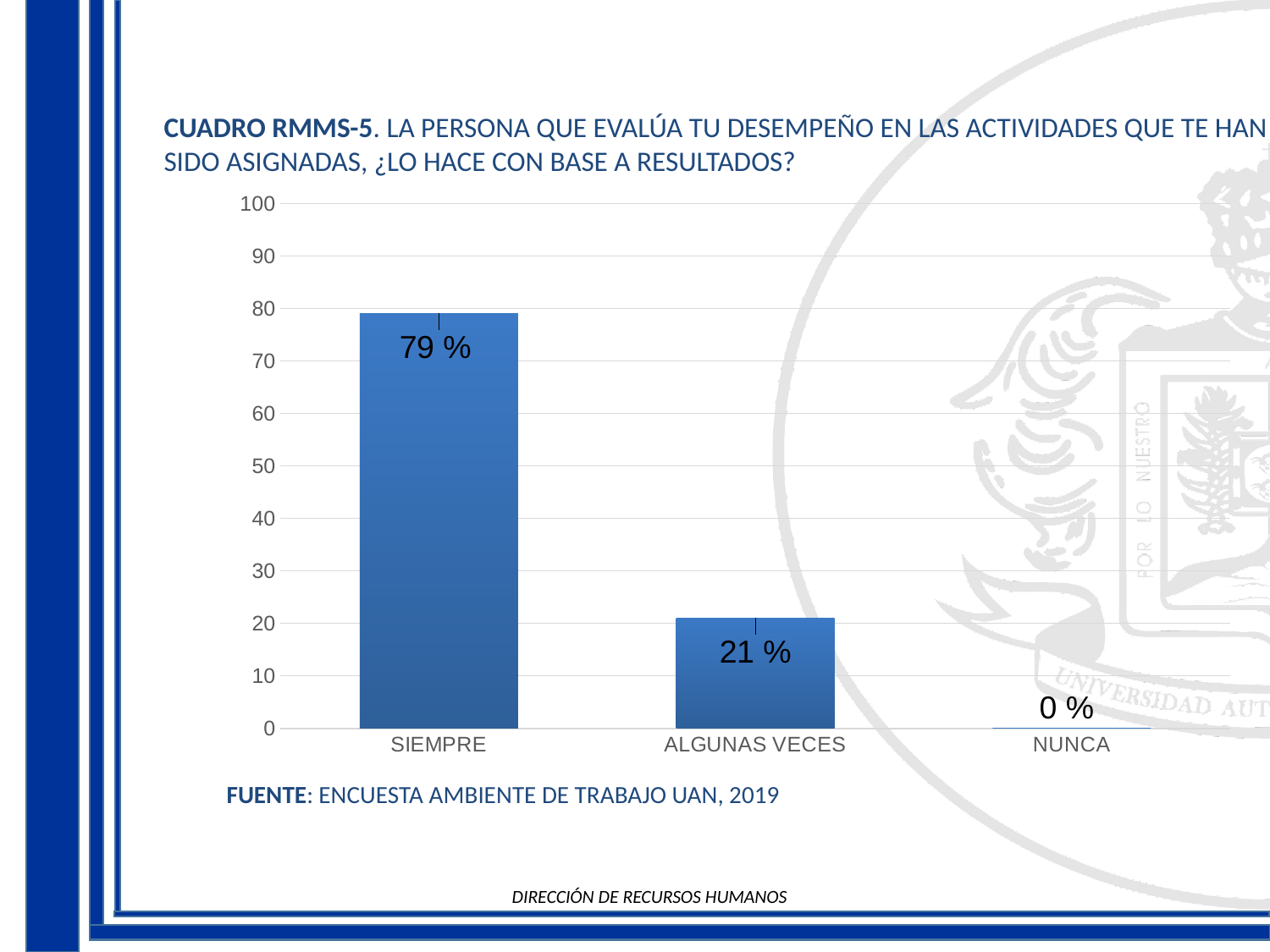
What is the value for NUNCA? 0 % Do the values rise or fall from left to right along the x axis? fall Is the value for ALGUNAS VECES greater or less than 30? less What is the difference between the values for SIEMPRE and ALGUNAS VECES? 58 % What kind of chart is shown on the slide? bar chart Is the value for SIEMPRE greater or less than 70? greater Which category has the highest value? SIEMPRE Which is larger, the value for ALGUNAS VECES or the value for NUNCA? ALGUNAS VECES What is the value for ALGUNAS VECES? 21 % How many categories are shown on the x axis? 3 Which category has the lowest value? NUNCA What is the value for SIEMPRE? 79 %